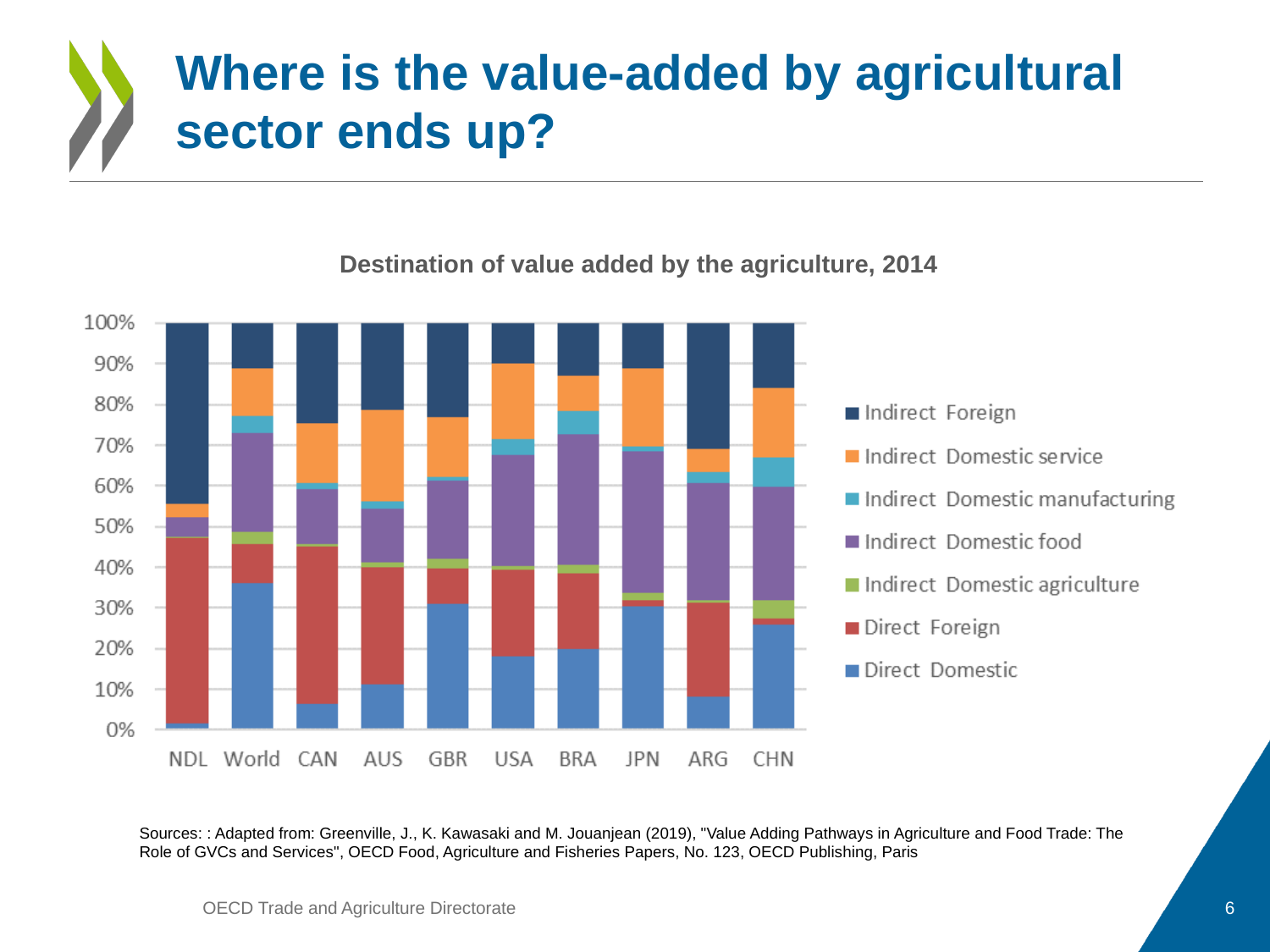
What kind of chart is shown on the slide? Stacked bar chart Which category has the largest Indirect Foreign segment? NDL How many categories are shown along the x axis of the chart? 10 How many series does the chart's legend list? 7 Which has the larger Indirect Foreign segment, ARG or USA? ARG What does each stacked bar total? 100% Which category has the largest Direct Domestic segment? World Which series is shown at the top of each stacked bar? Indirect Foreign Which category has the smallest Direct Domestic segment? NDL Is the Direct Domestic segment for World greater or less than 30%? greater What is the title of the chart? Destination of value added by the agriculture, 2014 Is the Direct Domestic segment for CAN greater or less than 10%? less